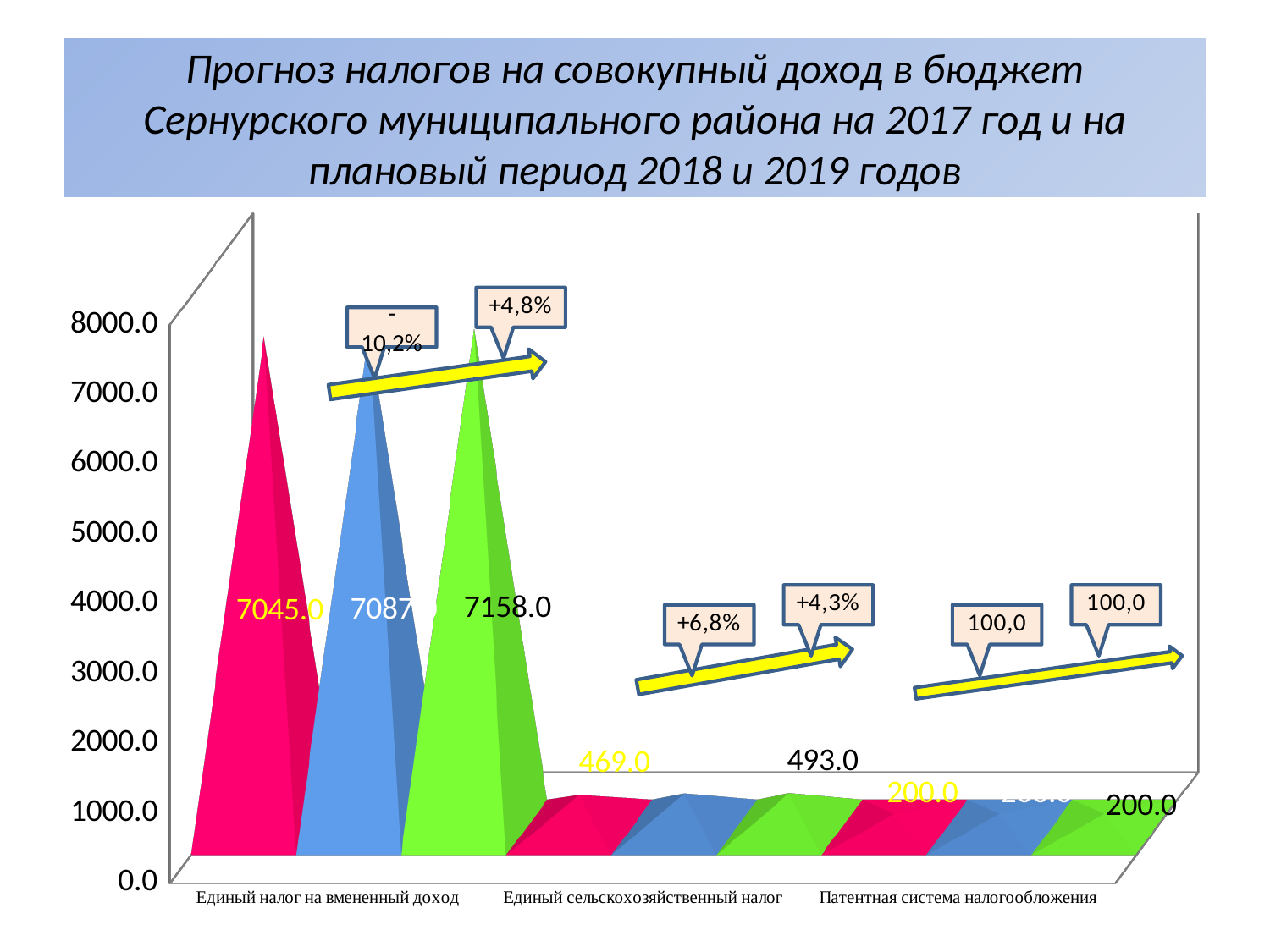
What is the value labelled in black for Единый сельскохозяйственный налог? 493.0 Which category has the highest values on the chart? Единый налог на вмененный доход What is the difference between the two labelled values for Единый сельскохозяйственный налог, 493.0 and 469.0? 24.0 What is the difference between the green pyramid value (7158.0) and the red pyramid value (7045.0) for Единый налог на вмененный доход? 113.0 What is the value shown on the leftmost (red) pyramid for Единый налог на вмененный доход? 7045.0 Are the values for Единый сельскохозяйственный налог greater or less than 1000.0? less What is the value labelled in yellow for Единый сельскохозяйственный налог? 469.0 What is the value shown on the rightmost (green) pyramid for Патентная система налогообложения? 200.0 Which category has the lowest values on the chart? Патентная система налогообложения What is the value shown on the green pyramid for Единый налог на вмененный доход? 7158.0 How many categories are shown on the x axis? 3 Do the values for Единый налог на вмененный доход rise or fall from the red pyramid to the green pyramid? rise